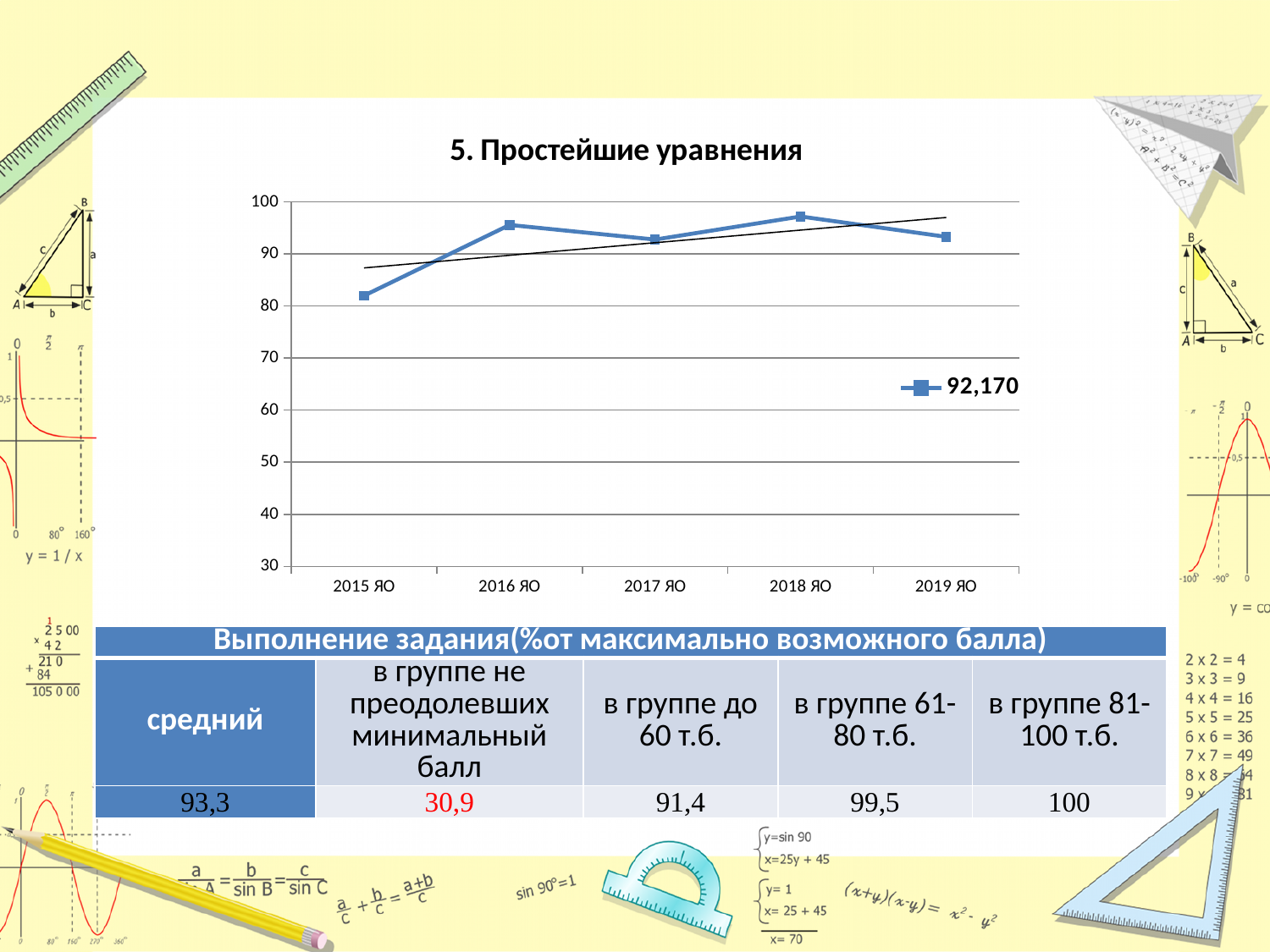
What is the title of the chart? 5. Простейшие уравнения Which year has the highest value on the chart? 2018 ЯО Is the value for 2016 ЯО greater or less than 90? greater Which year has the lowest value on the chart? 2015 ЯО Which is larger, the value for 2015 ЯО or the value for 2019 ЯО? 2019 ЯО How many data points are plotted along the x axis of the chart? 5 What entry is shown in the chart legend? 92,170 Does the black trend line on the chart rise or fall from 2015 ЯО to 2019 ЯО? rise How many series does the chart legend list? 1 Is the value for 2019 ЯО greater or less than 90? greater Is the value for 2015 ЯО greater or less than 90? less What kind of chart is shown on the slide? line chart